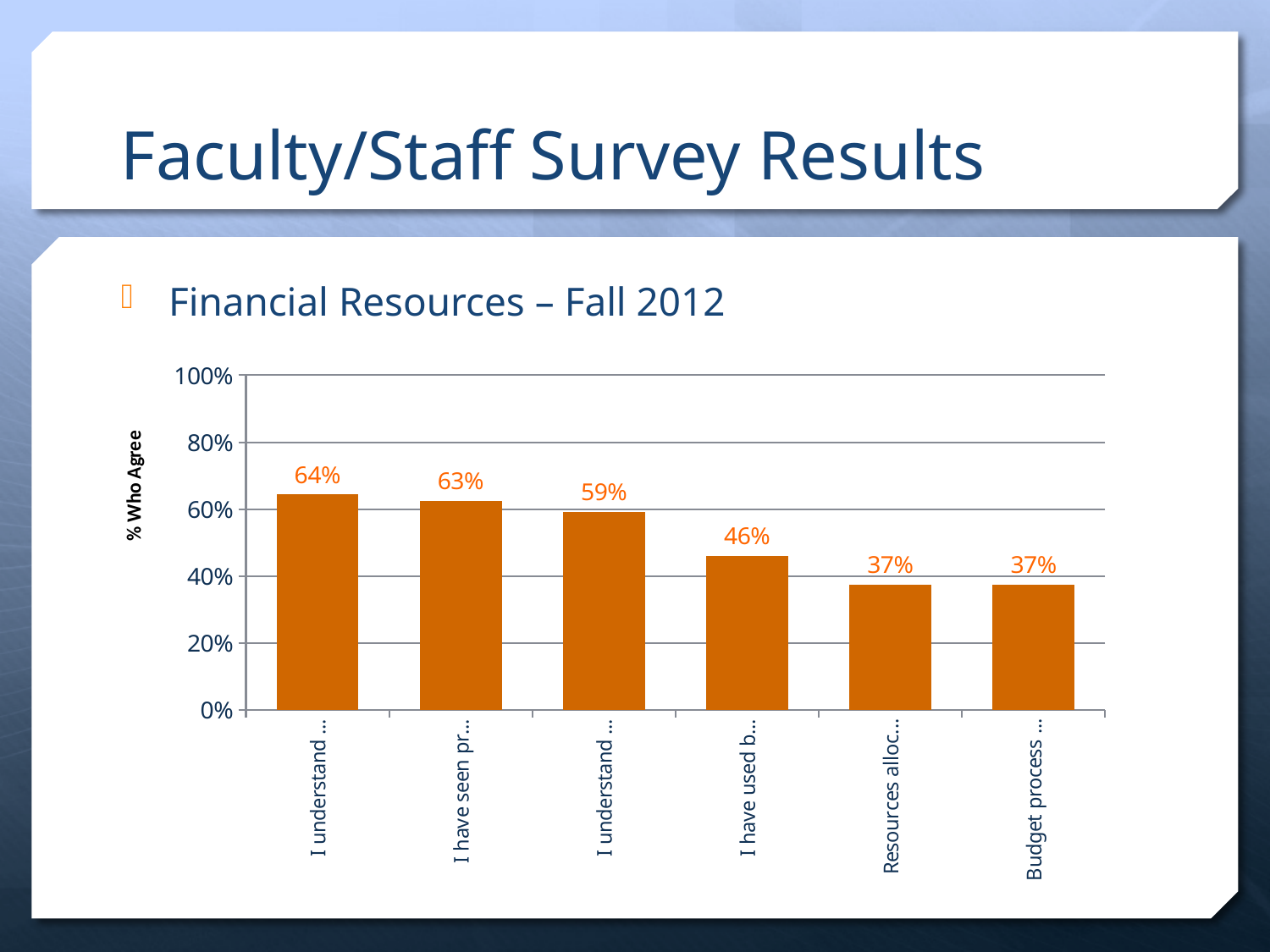
What is the value for the category labelled "Resources alloc..."? 37% What kind of chart is shown on the slide? bar chart Which has a larger value, "I have seen pr..." or "Budget process ..."? I have seen pr... Is the value for "I have used b..." greater or less than 60%? less How many bars are plotted in the chart? 6 What is the difference between the values for "I have seen pr..." and "I have used b..."? 17% What is the value for the category labelled "I have seen pr..."? 63% What is the title of the vertical axis? % Who Agree What is the value for the category labelled "I have used b..."? 46% What is the lowest value shown in the chart? 37% Do the bar values rise or fall from left to right across the chart? fall What is the highest value shown in the chart? 64%